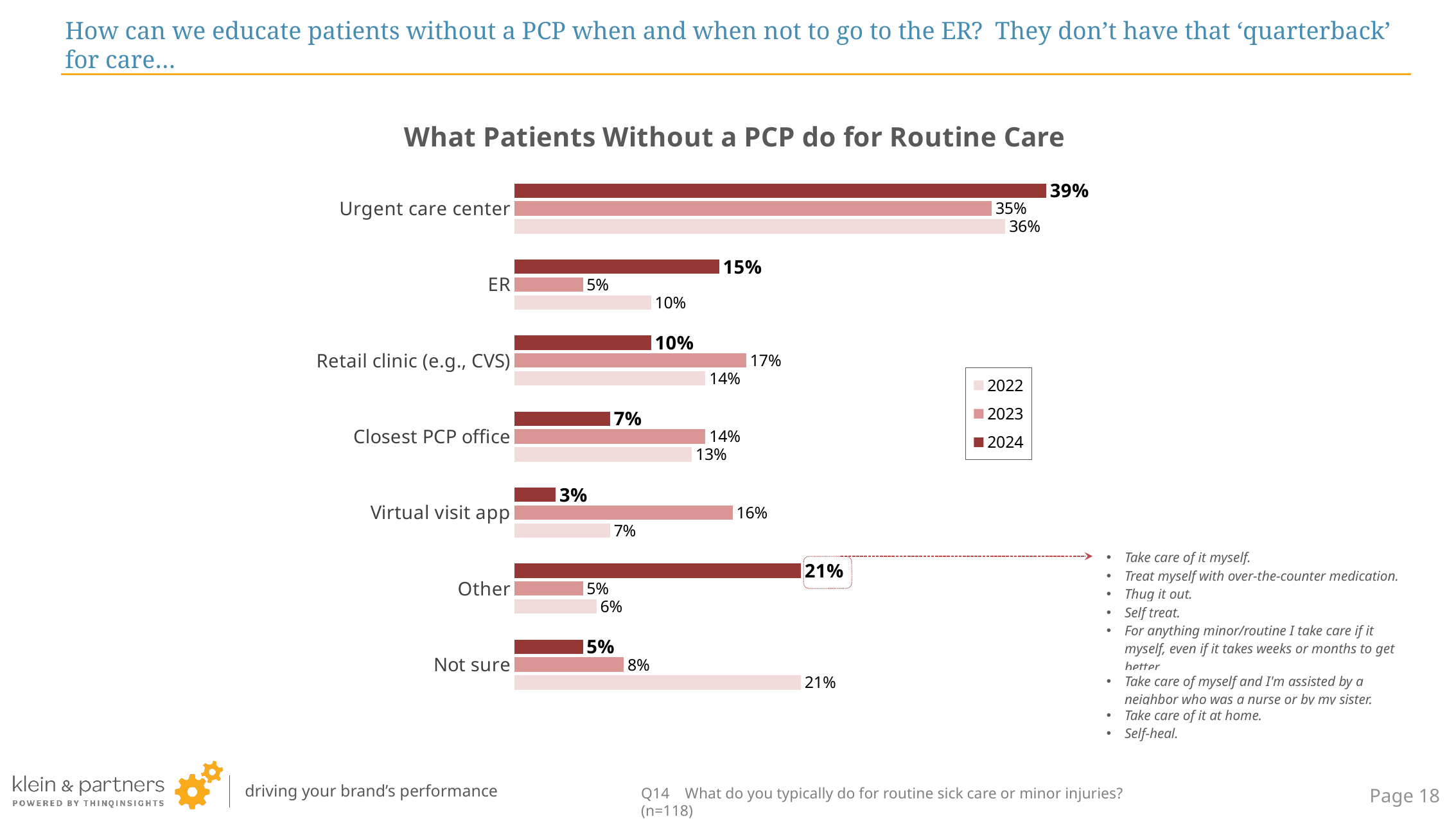
What is the title of the chart? What Patients Without a PCP do for Routine Care How many categories are shown on the chart? 7 What type of chart is shown? Bar chart How many series does the legend list? 3 What is the difference between the 2024 and 2023 values for ER? 10% Which is larger for Retail clinic (e.g., CVS): the 2023 value or the 2024 value? 2023 What is the 2023 value for Virtual visit app? 16% What is the 2024 value for Other? 21% What is the 2022 value for Not sure? 21% Which category has the highest 2024 value? Urgent care center Which category has the lowest 2024 value? Virtual visit app What is the 2024 value for Urgent care center? 39%